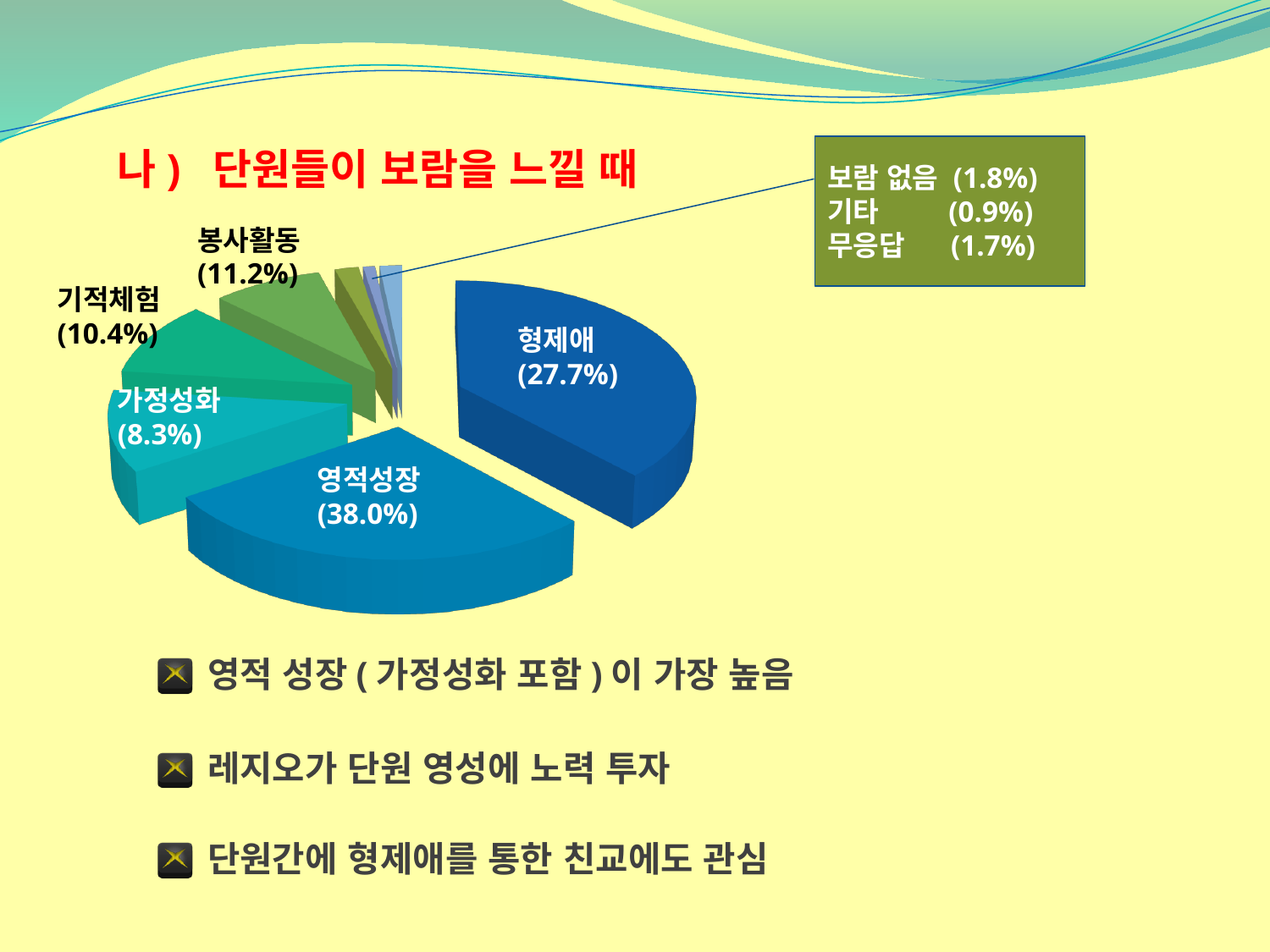
What percentage is shown for 영적성장? 38.0% What kind of chart is shown on the slide? pie chart Which category has the largest share of the pie? 영적성장 What percentage is shown for 봉사활동? 11.2% Which is larger, the share for 봉사활동 or the share for 기적체험? 봉사활동 What percentage is shown for 형제애? 27.7% What percentage is shown for 가정성화? 8.3% How many categories are shown in the pie chart, including those listed in the box? 8 What is the difference between the percentages for 영적성장 and 형제애? 10.3% What percentage is shown for 무응답? 1.7% What percentage is shown for 기적체험? 10.4% Which category has the smallest share of the pie? 기타